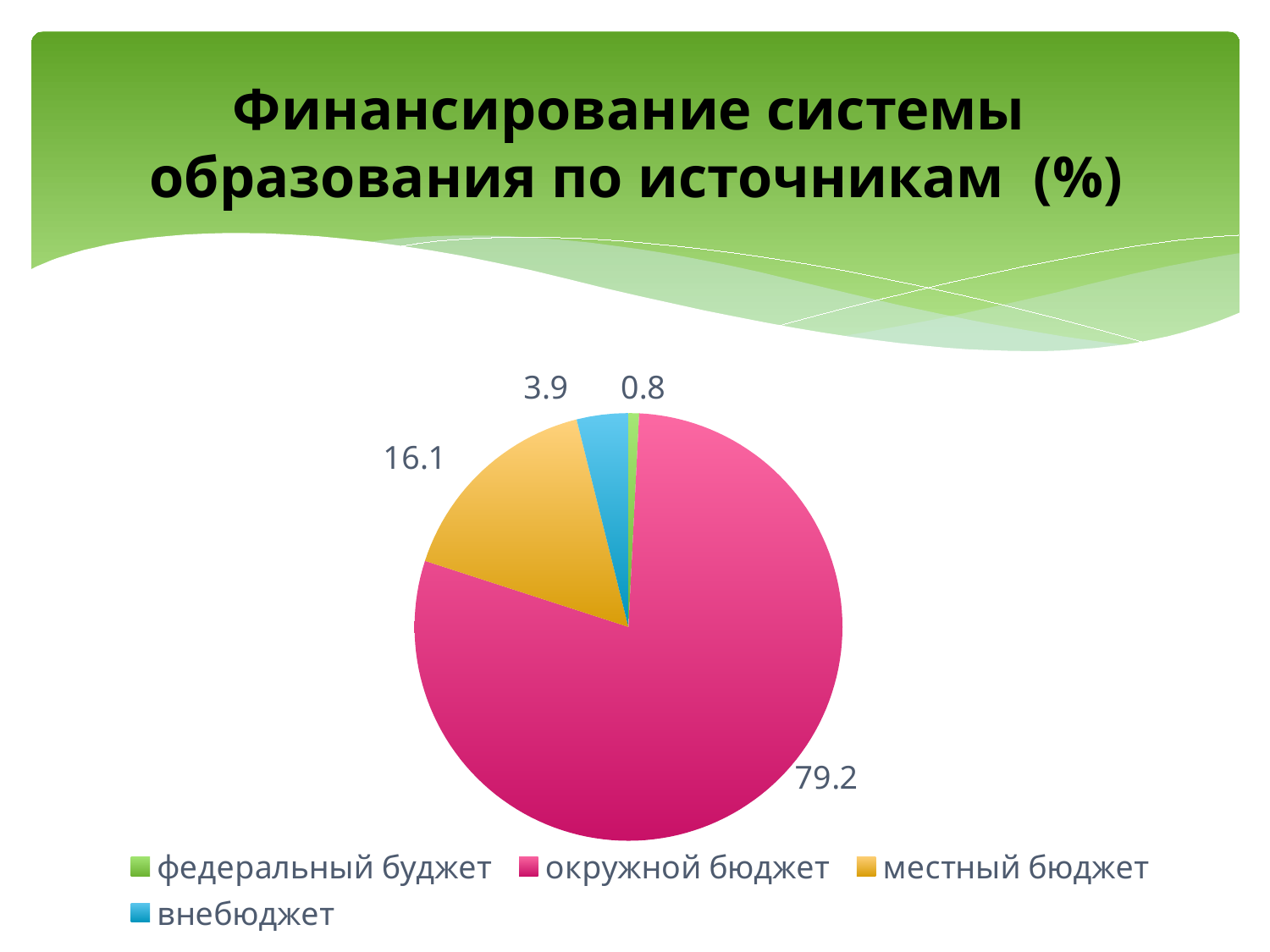
What is the title of the chart on the slide? Финансирование системы образования по источникам (%) What is the difference between the values for внебюджет and федеральный бюджет? 3.1 Which is larger, местный бюджет or внебюджет? местный бюджет What is the value for федеральный бюджет? 0.8 What is the value for внебюджет? 3.9 What kind of chart is shown on the slide? pie chart What is the value for окружной бюджет? 79.2 Which source has the largest share of the pie? окружной бюджет How many slices does the pie chart have? 4 What is the value for местный бюджет? 16.1 Which source has the smallest share of the pie? федеральный бюджет What is the difference between the values for окружной бюджет and местный бюджет? 63.1